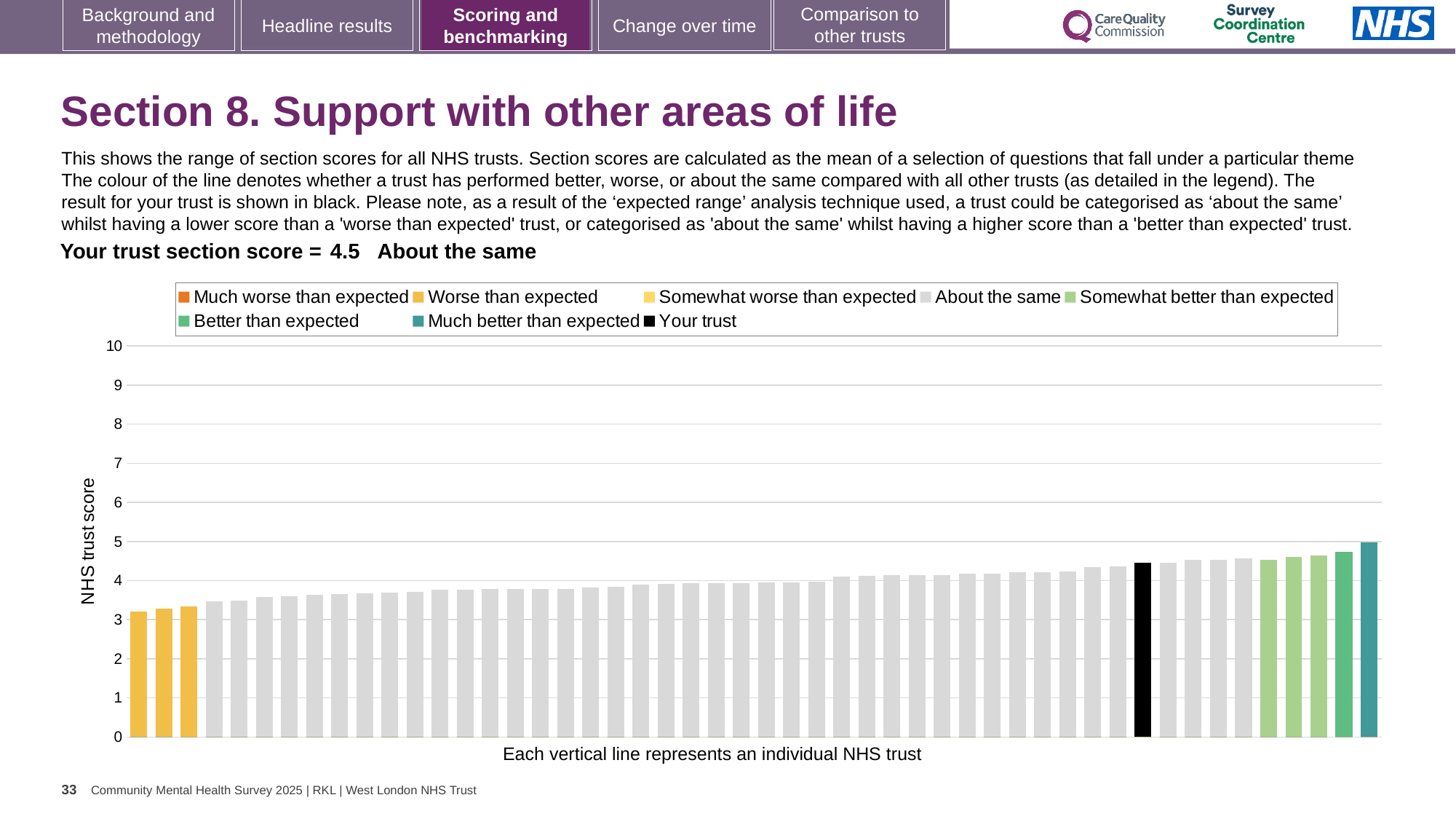
What kind of chart is shown on the slide? Bar chart Which legend category does the highest-scoring trust belong to? Much better than expected What is the label on the y axis of the chart? NHS trust score Which category is your trust placed in for this section? About the same Is the value for the lowest-scoring trust greater or less than 4? less Is the value for the highest-scoring trust greater or less than 4? greater Do the trust scores rise or fall from left to right along the x axis? rise How many trusts are shown in the 'Worse than expected' colour? 3 Is the value for your trust greater or less than 4? greater How many trusts are shown in the 'Somewhat better than expected' colour? 3 How many entries does the chart legend list? 8 What is the section score for your trust? 4.5